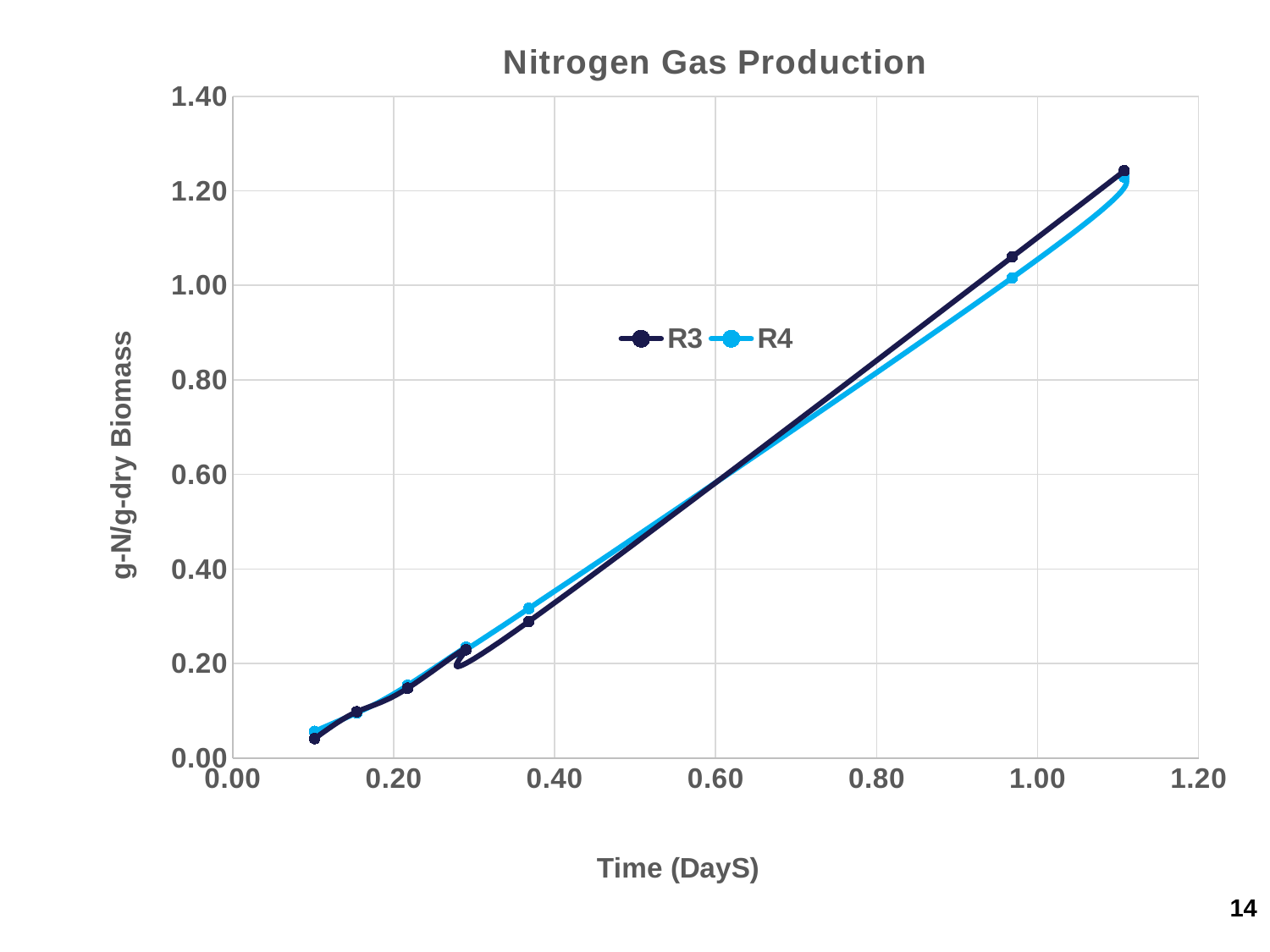
What is the title of the chart? Nitrogen Gas Production At about 0.97 days, which series has the larger value, R3 or R4? R3 Is the value for R3 at about 0.97 days greater or less than 1.00? greater What is the label of the x axis? Time (DayS) How many series does the legend list? 2 Do the values for R4 rise or fall as time increases along the x axis? rise What kind of chart is shown on the slide? line chart Which series reaches the highest value on the chart? R3 Is the value for R4 at about 0.37 days greater or less than 0.40? less Is the final value for R3 (at about 1.10 days) greater or less than 1.20? greater Do the values for R3 rise or fall as time increases along the x axis? rise